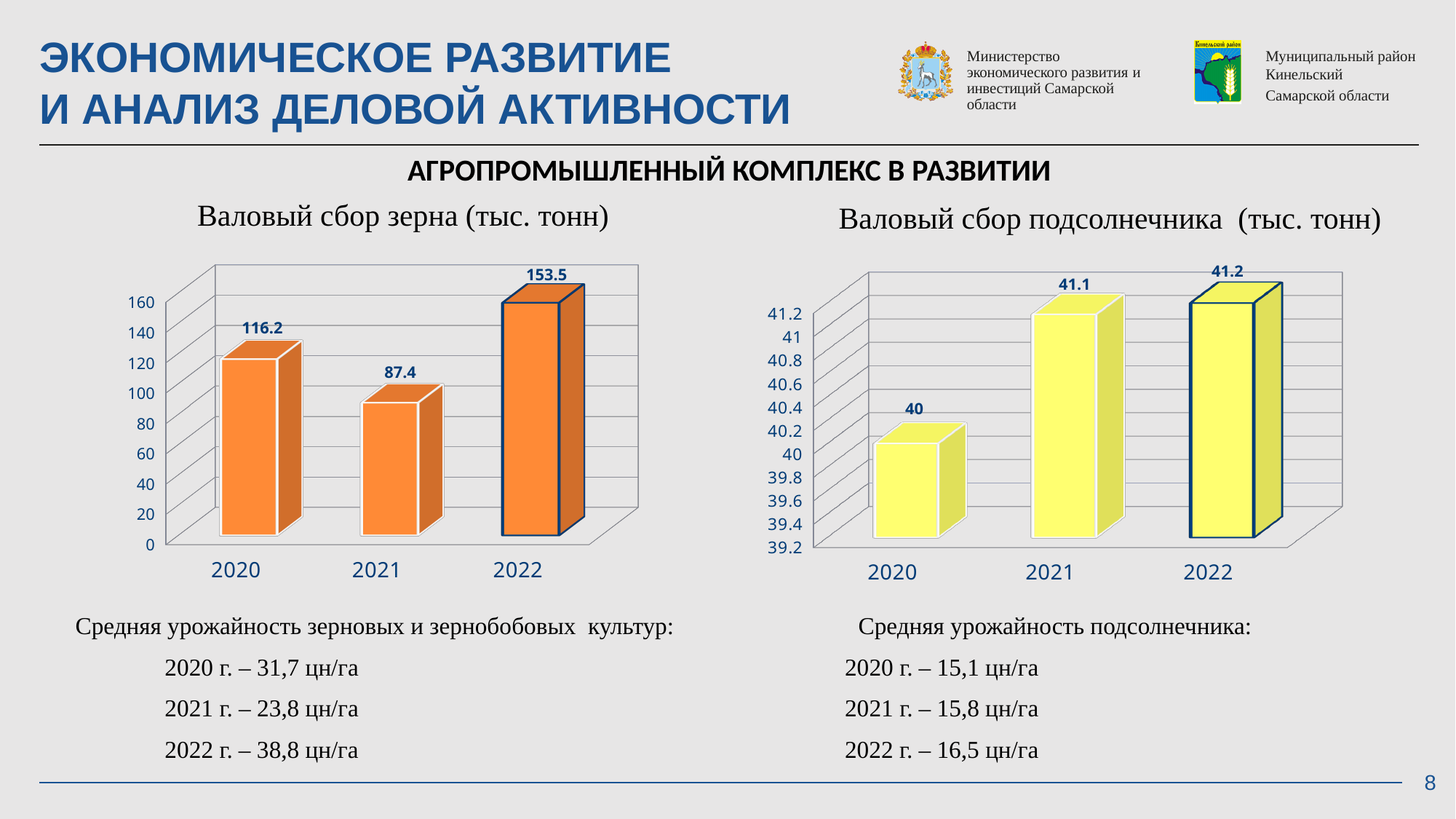
In the chart 'Валовый сбор подсолнечника (тыс. тонн)', which year has the lowest value? 2020 In the chart 'Валовый сбор зерна (тыс. тонн)', what is the difference between the 2022 and 2020 values? 37.3 In the chart 'Валовый сбор зерна (тыс. тонн)', what is the value for 2021? 87.4 In the chart 'Валовый сбор подсолнечника (тыс. тонн)', do the values rise or fall from 2020 to 2022? rise How many years are shown in the chart 'Валовый сбор зерна (тыс. тонн)'? 3 In the chart 'Валовый сбор зерна (тыс. тонн)', which year has the lowest value? 2021 In the chart 'Валовый сбор зерна (тыс. тонн)', what is the value for 2022? 153.5 In the chart 'Валовый сбор подсолнечника (тыс. тонн)', what is the difference between the 2022 and 2020 values? 1.2 In the chart 'Валовый сбор подсолнечника (тыс. тонн)', what is the value for 2020? 40 In the chart 'Валовый сбор зерна (тыс. тонн)', which year has the highest value? 2022 In the chart 'Валовый сбор подсолнечника (тыс. тонн)', what is the value for 2021? 41.1 In the chart 'Валовый сбор зерна (тыс. тонн)', is the value for 2020 greater or less than 100? greater